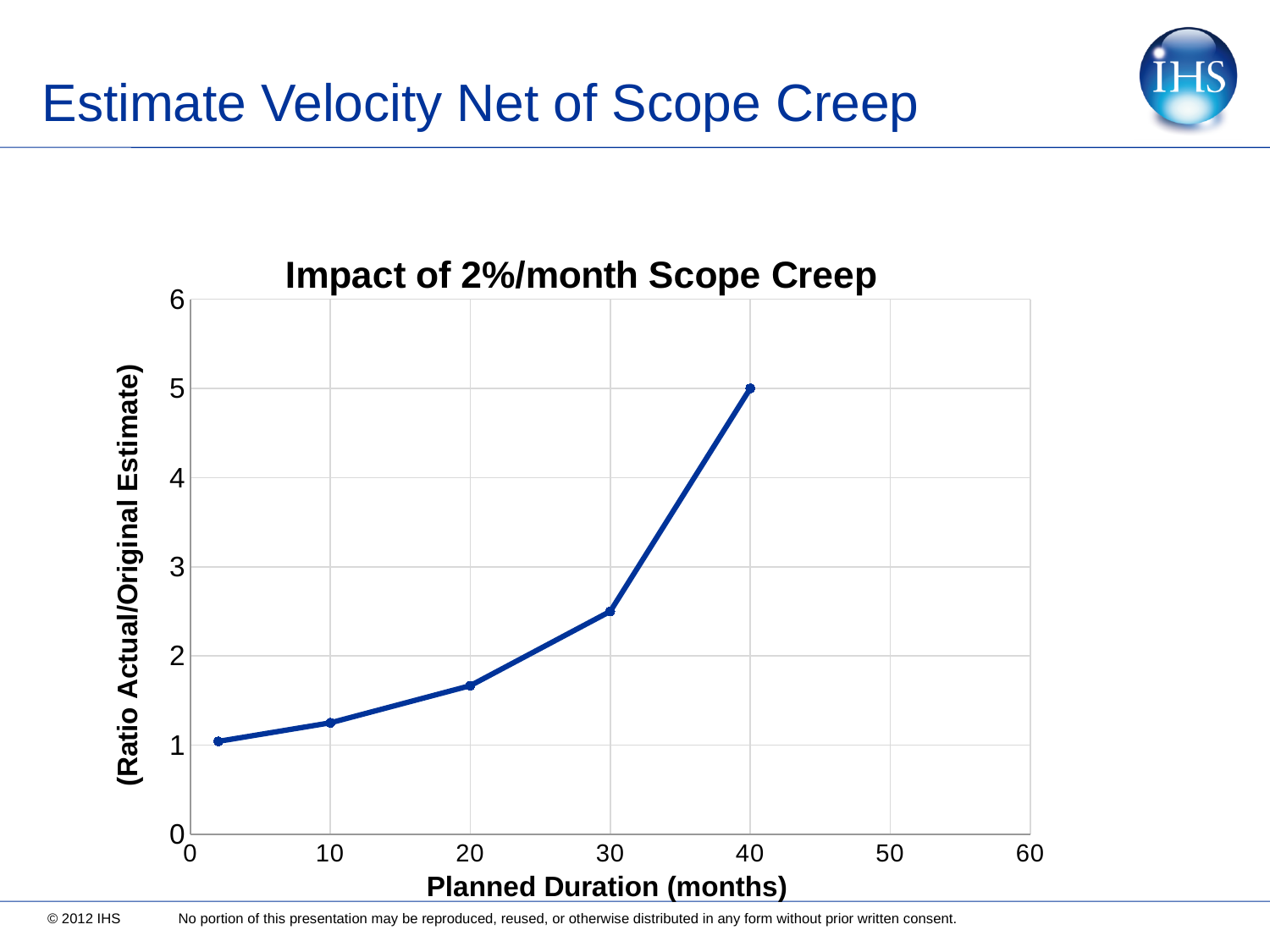
Does the ratio rise or fall as planned duration increases? rises At which planned duration is the ratio highest? 40 What kind of chart is shown on the slide? line chart Is the value at a planned duration of 30 months greater or less than 3? less Which has the larger ratio, a planned duration of 20 months or 30 months? 30 months What is the label of the x axis? Planned Duration (months) What is the ratio of actual to original estimate at a planned duration of 40 months? 5 What is the title of the chart? Impact of 2%/month Scope Creep Is the value at a planned duration of 20 months greater or less than 2? less How many data points are plotted on the line? 5 Is the value at a planned duration of 30 months greater or less than 2? greater